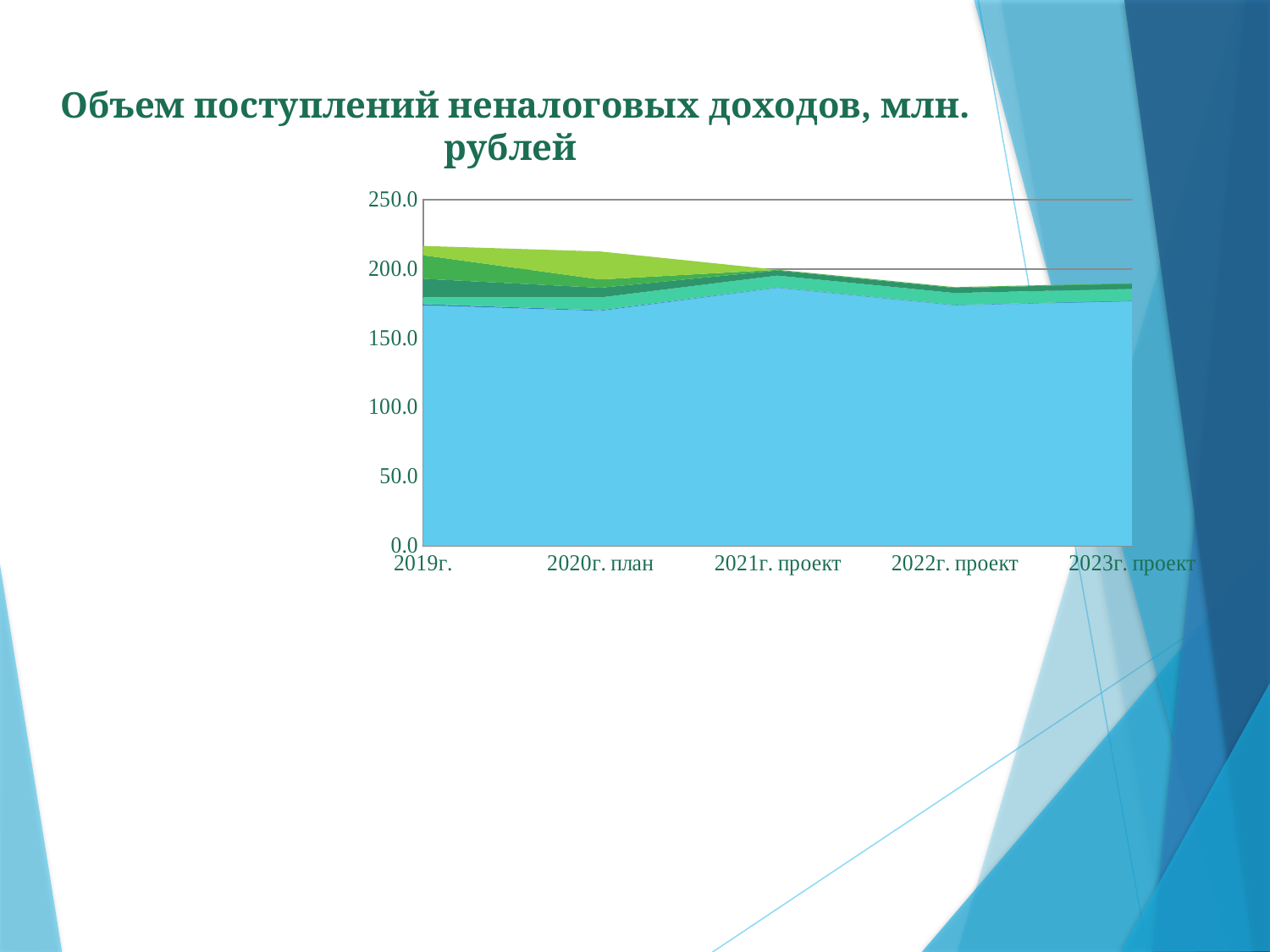
Is the total stacked value for 2019г. greater or less than 200? greater What kind of chart is shown on the slide? Area chart Does the total stacked value rise or fall from 2019г. to 2022г. проект? fall How many categories are shown along the x axis of the chart? 5 Which has the larger total stacked value, 2020г. план or 2023г. проект? 2020г. план Is the value of the bottom (light blue) series for 2019г. greater or less than 200? less Is the total stacked value for 2022г. проект greater or less than 200? less What is the title of the chart on the slide? Объем поступлений неналоговых доходов, млн. рублей Which has the larger total stacked value, 2019г. or 2022г. проект? 2019г. What is the highest value shown on the vertical axis of the chart? 250.0